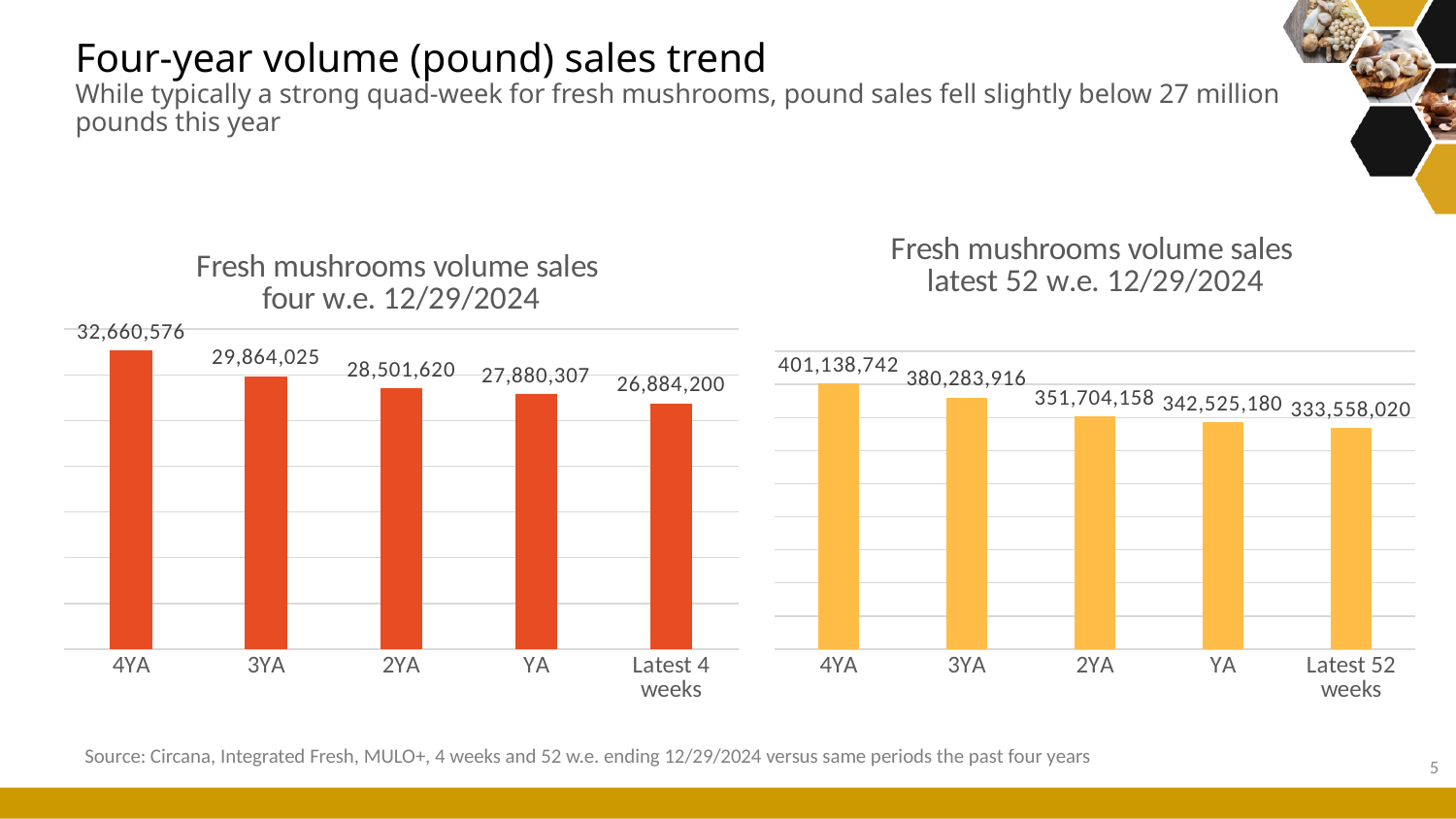
In the 'Fresh mushrooms volume sales latest 52 w.e. 12/29/2024' chart, what is the value for YA? 342,525,180 In the 'Fresh mushrooms volume sales latest 52 w.e. 12/29/2024' chart, do the values rise or fall from 4YA to Latest 52 weeks? Fall In the 'Fresh mushrooms volume sales four w.e. 12/29/2024' chart, what is the value for Latest 4 weeks? 26,884,200 In the 'Fresh mushrooms volume sales latest 52 w.e. 12/29/2024' chart, what is the difference between the 4YA value and the 3YA value? 20,854,826 In the 'Fresh mushrooms volume sales four w.e. 12/29/2024' chart, which is larger, the value for 3YA or the value for 2YA? 3YA In the 'Fresh mushrooms volume sales four w.e. 12/29/2024' chart, what is the value for 4YA? 32,660,576 What kind of chart is the 'Fresh mushrooms volume sales four w.e. 12/29/2024' chart? Bar chart In the 'Fresh mushrooms volume sales latest 52 w.e. 12/29/2024' chart, which category has the lowest value? Latest 52 weeks How many categories are shown in the 'Fresh mushrooms volume sales latest 52 w.e. 12/29/2024' chart? 5 In the 'Fresh mushrooms volume sales four w.e. 12/29/2024' chart, which category has the highest value? 4YA In the 'Fresh mushrooms volume sales four w.e. 12/29/2024' chart, what is the difference between the 4YA value and the Latest 4 weeks value? 5,776,376 In the 'Fresh mushrooms volume sales latest 52 w.e. 12/29/2024' chart, what is the value for 2YA? 351,704,158